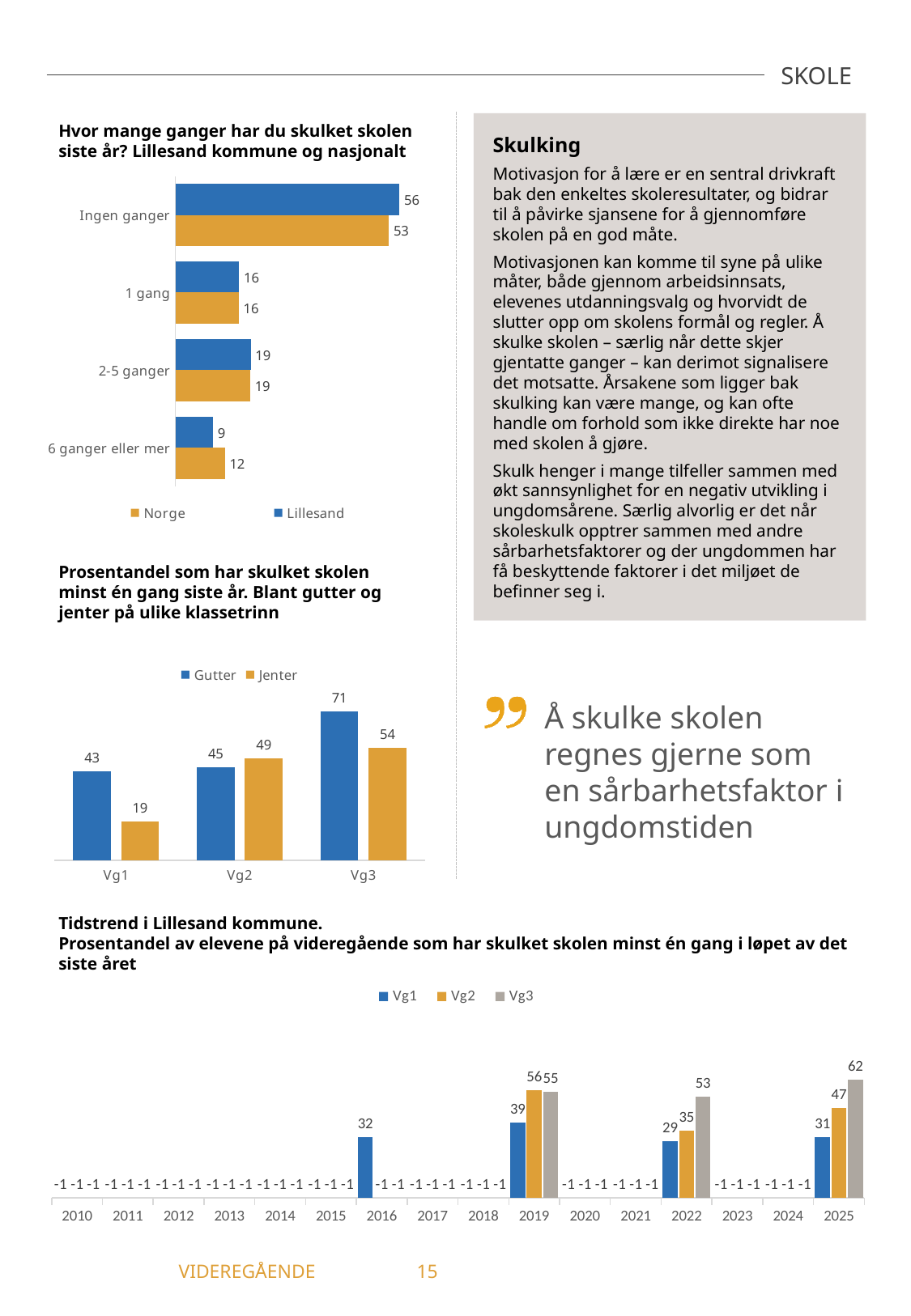
In the chart 'Hvor mange ganger har du skulket skolen siste år?', how many series does the legend list? 2 What kind of chart is 'Prosentandel som har skulket skolen minst én gang siste år'? Bar chart In the chart 'Hvor mange ganger har du skulket skolen siste år?', what is the value for Lillesand in the 'Ingen ganger' category? 56 In the chart 'Prosentandel som har skulket skolen minst én gang siste år', what is the value for Jenter at Vg1? 19 In the chart 'Prosentandel som har skulket skolen minst én gang siste år', which class level has the highest value for Gutter? Vg3 In the chart 'Tidstrend i Lillesand kommune', what is the value for Vg1 in 2016? 32 In the chart 'Tidstrend i Lillesand kommune', what is the value for Vg3 in 2025? 62 In the chart 'Prosentandel som har skulket skolen minst én gang siste år', what is the difference between Gutter and Jenter at Vg3? 17 In the chart 'Prosentandel som har skulket skolen minst én gang siste år', which is larger at Vg2, Gutter or Jenter? Jenter In the chart 'Hvor mange ganger har du skulket skolen siste år?', what is the value for Norge in the '6 ganger eller mer' category? 12 In the chart 'Hvor mange ganger har du skulket skolen siste år?', what is the difference between the Norge and Lillesand values for '6 ganger eller mer'? 3 In the chart 'Tidstrend i Lillesand kommune', how many series does the legend list? 3